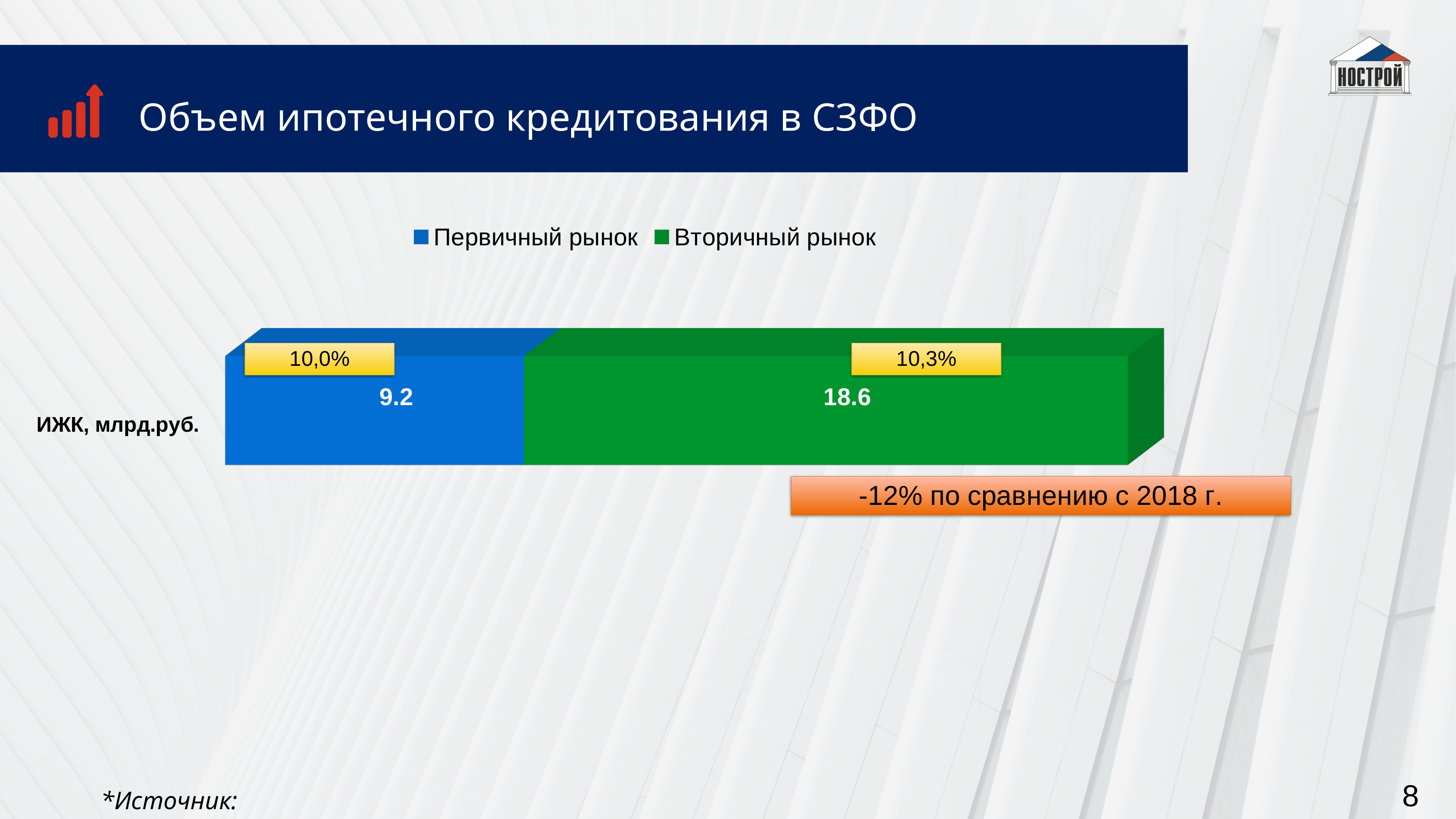
Which series has the largest value in the chart? Вторичный рынок Which series has the larger value, Первичный рынок or Вторичный рынок? Вторичный рынок What is the total of the stacked bar for ИЖК, млрд.руб.? 27.8 What is the difference between the Вторичный рынок value and the Первичный рынок value? 9.4 Which series has the smallest value in the chart? Первичный рынок What is the value for Первичный рынок in the ИЖК, млрд.руб. bar? 9.2 How many series does the legend list? 2 Which colour represents Вторичный рынок in the chart? Green What kind of chart is shown on the slide? Stacked bar chart How many categories are plotted in the chart? 1 What is the title of the slide containing the chart? Объем ипотечного кредитования в СЗФО What is the value for Вторичный рынок in the ИЖК, млрд.руб. bar? 18.6